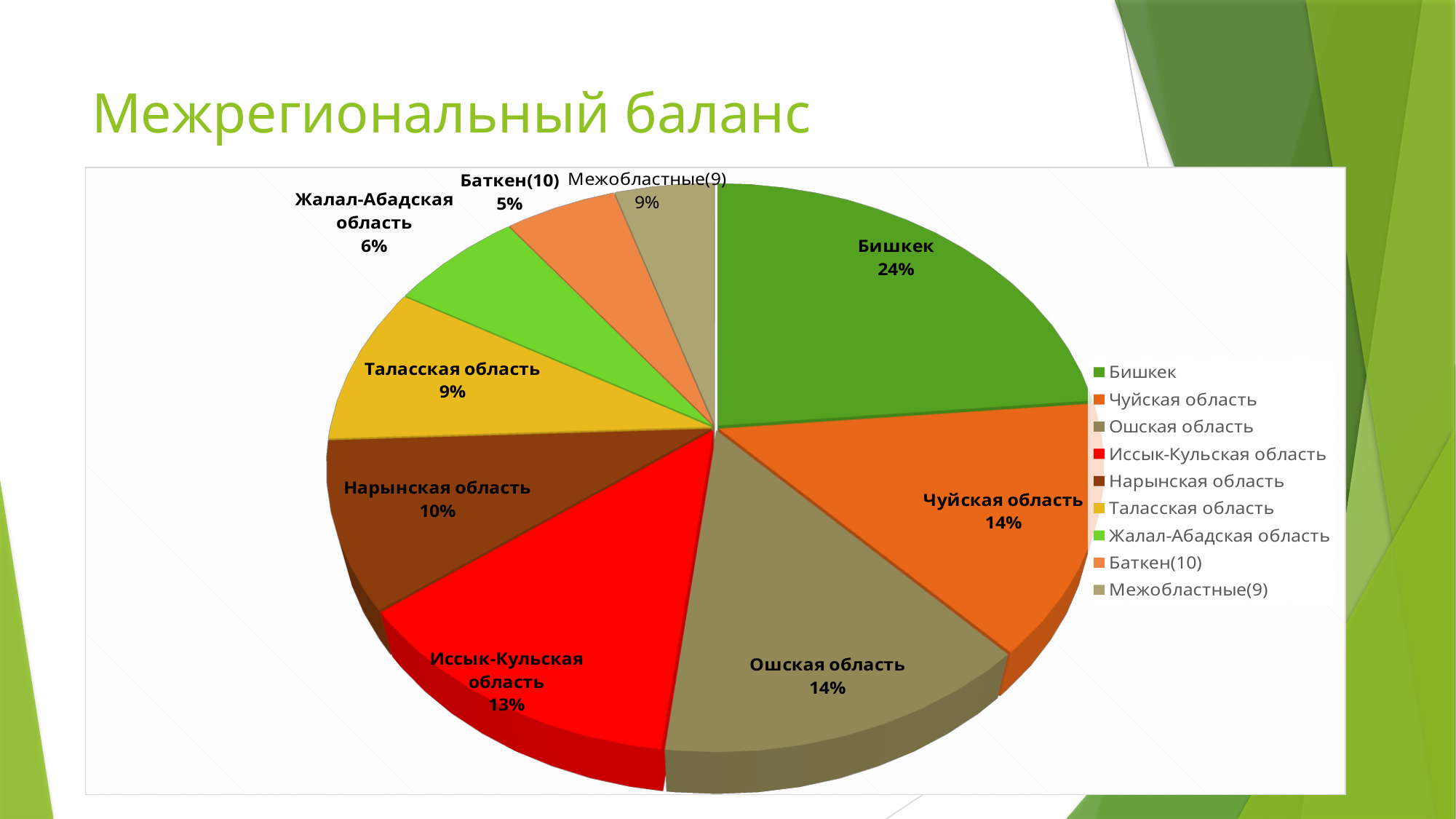
How many slices does the pie chart have? 9 What is the difference in percentage points between Бишкек and Иссык-Кульская область? 11 What share of the pie does Бишкек have? 24% What is the title of the slide? Межрегиональный баланс What share of the pie does Баткен(10) have? 5% What kind of chart is shown on the slide? Pie chart Which is larger, the share for Нарынская область or the share for Жалал-Абадская область? Нарынская область Which category has the largest slice of the pie? Бишкек How many entries does the legend list? 9 What share of the pie does Нарынская область have? 10%